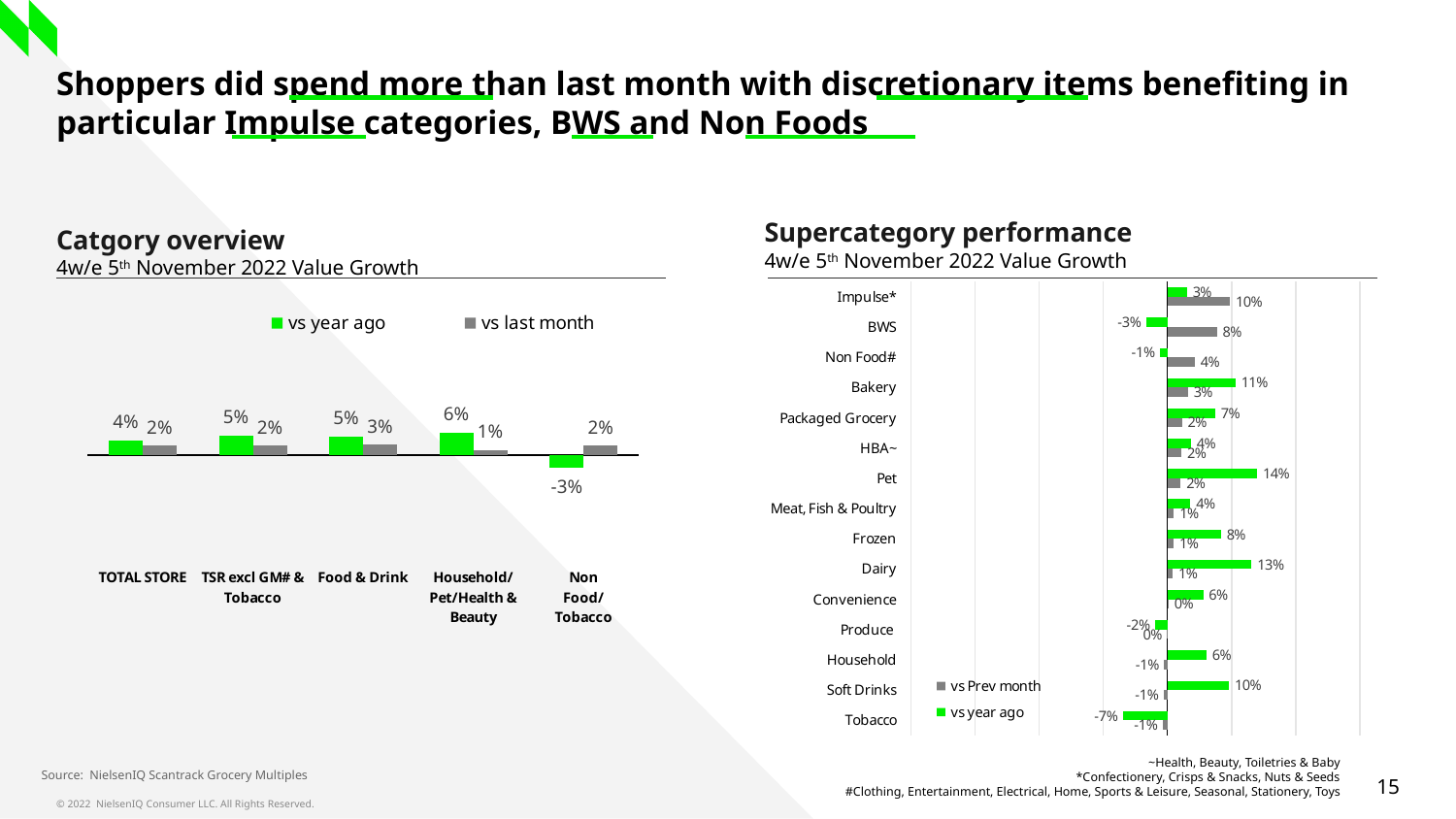
In the 'Catgory overview' chart, what is the 'vs last month' value for Food & Drink? 3% In the 'Supercategory performance' chart, which supercategory has the highest 'vs Prev month' value? Impulse* In the 'Catgory overview' chart, what is the difference between the 'vs year ago' and 'vs last month' values for Household/Pet/Health & Beauty? 5% In the 'Supercategory performance' chart, what is the 'vs year ago' value for Pet? 14% In the 'Catgory overview' chart, how many categories are shown on the x axis? 5 In the 'Catgory overview' chart, which category has the lowest 'vs year ago' value? Non Food/ Tobacco What type of chart is the 'Supercategory performance' chart? Bar chart In the 'Catgory overview' chart, what is the 'vs year ago' value for TOTAL STORE? 4% In the 'Supercategory performance' chart, how many supercategories are listed? 15 In the 'Supercategory performance' chart, what is the 'vs Prev month' value for BWS? 8% In the 'Supercategory performance' chart, which is larger: the 'vs year ago' value for Dairy or for Frozen? Dairy In the 'Supercategory performance' chart, which supercategory has the lowest 'vs year ago' value? Tobacco